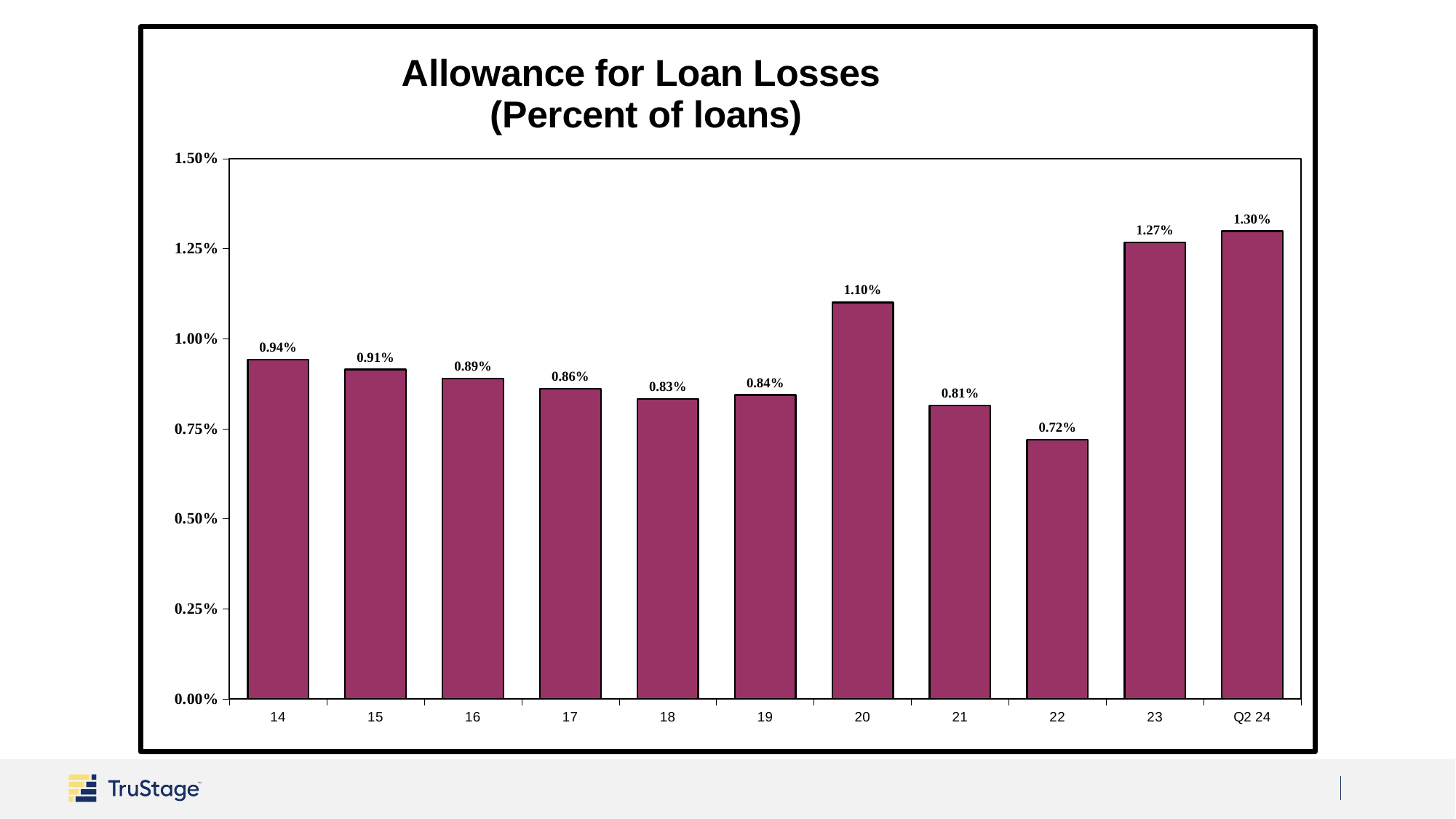
Which category has the highest allowance for loan losses? Q2 24 Is the value for 21 greater or less than 1.00%? less What is the title of the chart? Allowance for Loan Losses (Percent of loans) What is the value shown for Q2 24? 1.30% What is the allowance for loan losses as a percent of loans in 20? 1.10% Which category has the lowest allowance for loan losses? 22 Do the values rise or fall from 14 to 18? fall What is the value shown for 18? 0.83% Which is larger, the value for 14 or the value for 15? 14 What kind of chart is shown on the slide? bar chart How many categories are shown on the x axis? 11 What is the difference between the values for 23 and 22? 0.55%